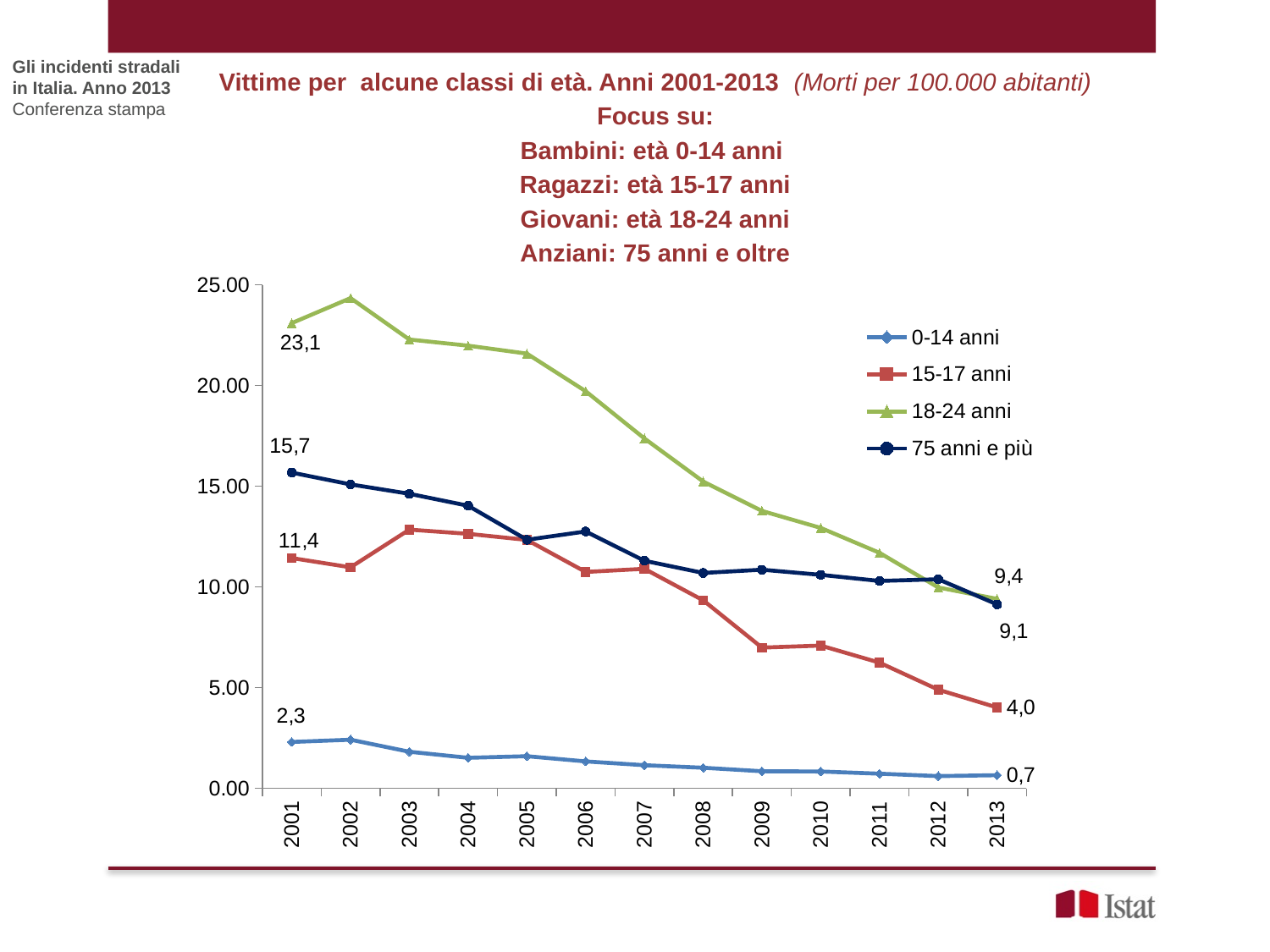
What is the value for the 15-17 anni series in 2013? 4,0 Is the value for the 18-24 anni series in 2002 greater or less than 20.00? greater How many series does the legend list? 4 Which series has the highest value in 2001? 18-24 anni What kind of chart is shown on the slide? line chart What is the value for the 0-14 anni series in 2013? 0,7 What is the value for the 18-24 anni series in 2001? 23,1 What is the difference between the 18-24 anni values in 2001 and 2013? 13,7 Does the 15-17 anni series rise or fall overall from 2001 to 2013? fall Which series has the lowest value in 2013? 0-14 anni How many years are shown on the x axis? 13 What is the value for the 75 anni e più series in 2001? 15,7